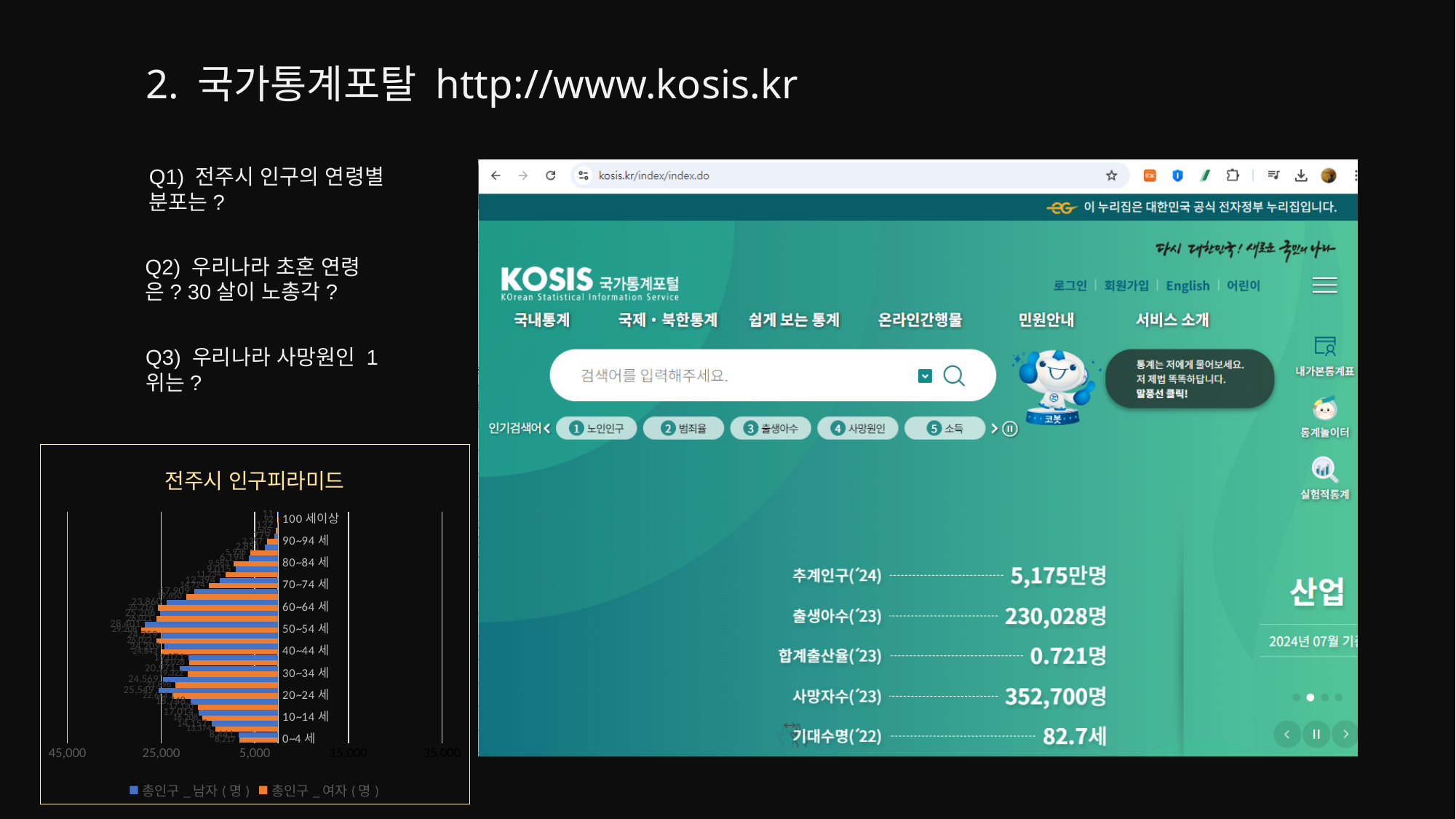
What is the title of the chart on the slide? 전주시 인구피라미드 In the 전주시 인구피라미드 chart, is the male population for 100세이상 greater or less than 5,000? less How many series does the legend of the 전주시 인구피라미드 chart list? 2 In the 전주시 인구피라미드 chart, which age group has the larger female population, 100세이상 or 40~44세? 40~44세 How many age-group labels are printed along the vertical axis of the 전주시 인구피라미드 chart? 11 In the 전주시 인구피라미드 chart, do the bars get longer or shorter moving from 60~64세 up to 100세이상? shorter What type of chart is the 전주시 인구피라미드 chart? bar chart Which colour represents 총인구_남자(명) in the 전주시 인구피라미드 chart? blue In the 전주시 인구피라미드 chart, is the male population for 0~4세 greater or less than 25,000? less In the 전주시 인구피라미드 chart, which age group has the larger male population, 0~4세 or 50~54세? 50~54세 In the 전주시 인구피라미드 chart, is the female population for 90~94세 greater or less than 5,000? less